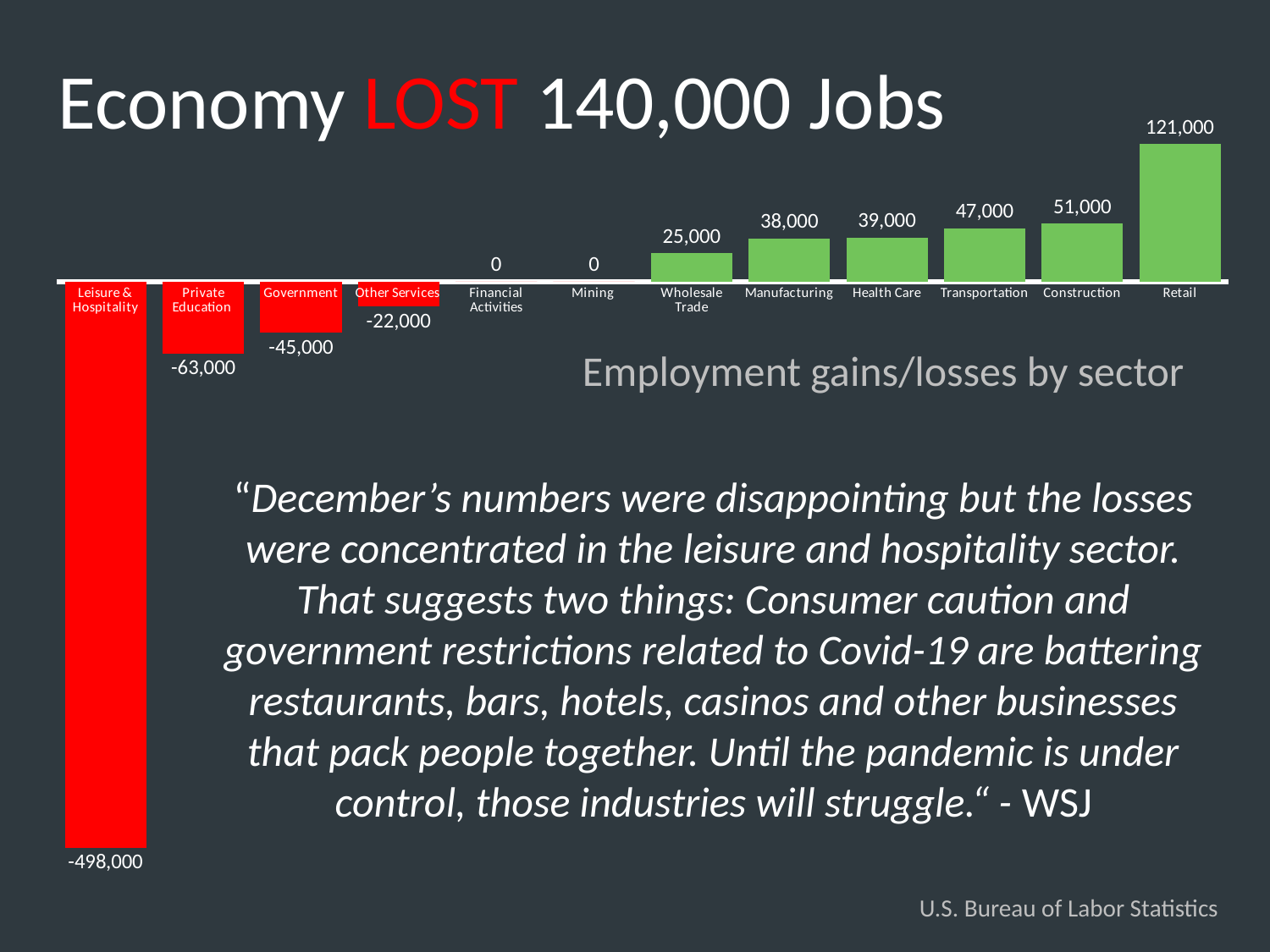
What is the value for Government? -45,000 What kind of chart is shown on the slide? Bar chart What is the value for Health Care? 39,000 Which is larger, the value for Manufacturing or the value for Wholesale Trade? Manufacturing What colour are the bars for sectors with job losses? Red Which sector has the lowest value? Leisure & Hospitality Which two sectors have a value of 0? Financial Activities and Mining How many sectors are shown in the chart? 12 What is the difference between the values for Construction and Transportation? 4,000 What is the value for Retail? 121,000 Which sector has the highest value? Retail What is the value for Leisure & Hospitality? -498,000